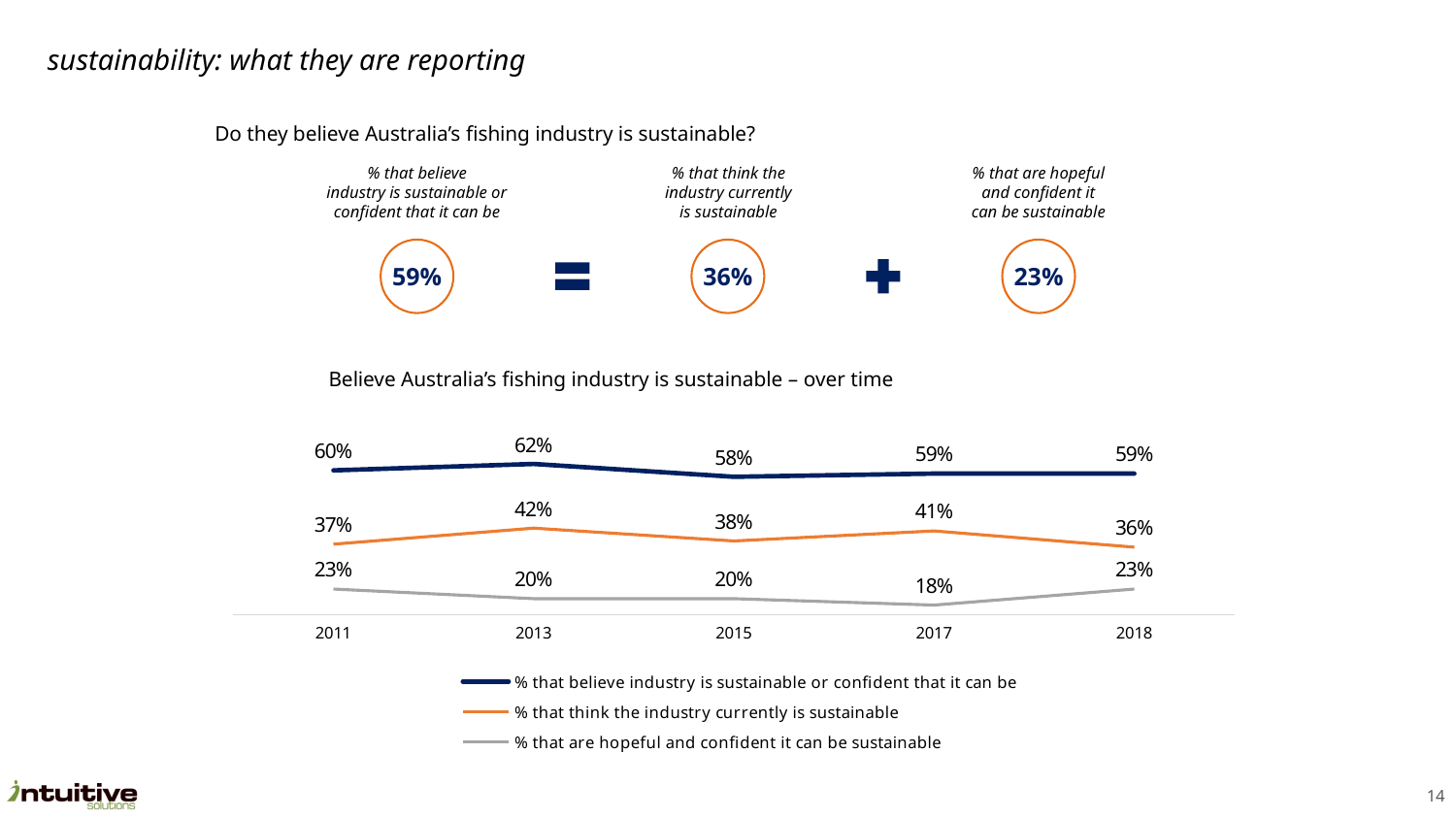
In the line chart, what is the value for '% that think the industry currently is sustainable' in 2013? 42% In the line chart, which year has the highest value for '% that believe industry is sustainable or confident that it can be'? 2013 In the line chart, what is the difference between the 2013 and 2018 values for '% that think the industry currently is sustainable'? 6% How many years are plotted on the x axis of the line chart? 5 In the line chart, which year has the lowest value for '% that are hopeful and confident it can be sustainable'? 2017 In the line chart, which is larger: the 2011 value or the 2018 value for '% that think the industry currently is sustainable'? 2011 How many series does the legend of the line chart list? 3 In the line chart, does '% that are hopeful and confident it can be sustainable' rise or fall from 2017 to 2018? Rise In the line chart, what is the value for '% that are hopeful and confident it can be sustainable' in 2017? 18% What type of chart is shown under 'Believe Australia's fishing industry is sustainable – over time'? Line chart In the line chart, what is the value for '% that believe industry is sustainable or confident that it can be' in 2015? 58% What colour is the line for '% that think the industry currently is sustainable'? Orange